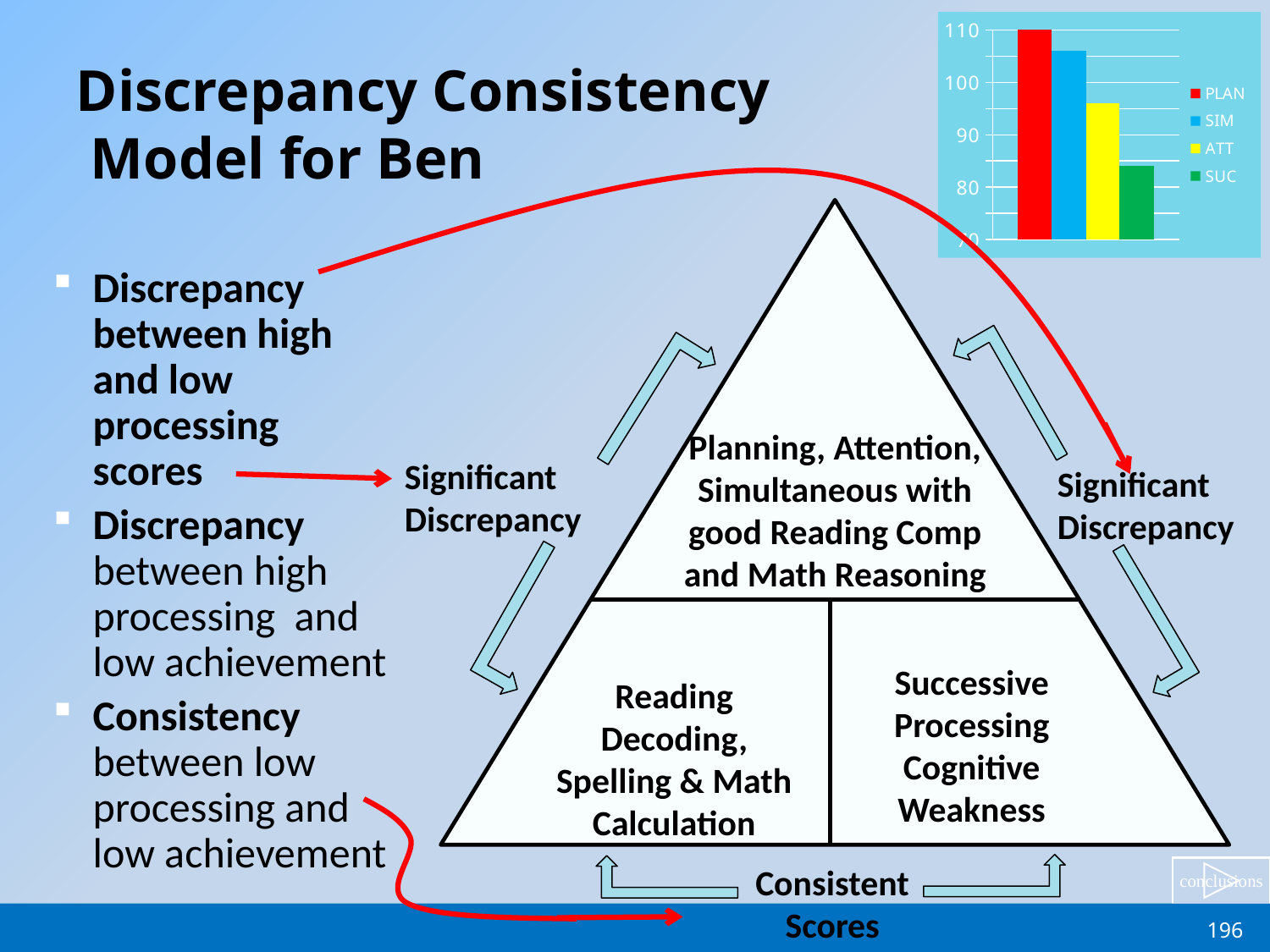
What colour is the PLAN series in the bar chart? red How many bars are plotted in the bar chart? 4 Which series has the lowest bar in the bar chart? SUC How many series does the legend of the bar chart list? 4 Is the value for ATT in the bar chart greater or less than 100? less What kind of chart is shown in the top right corner of the slide? bar chart Which series has the highest bar in the bar chart? PLAN Is the value for SIM in the bar chart greater or less than 100? greater Is the value for SUC in the bar chart greater or less than 90? less Do the bar values rise or fall moving from left to right across the bar chart? fall In the bar chart, which is larger, the value for ATT or the value for SUC? ATT In the bar chart, which is larger, the value for SIM or the value for ATT? SIM